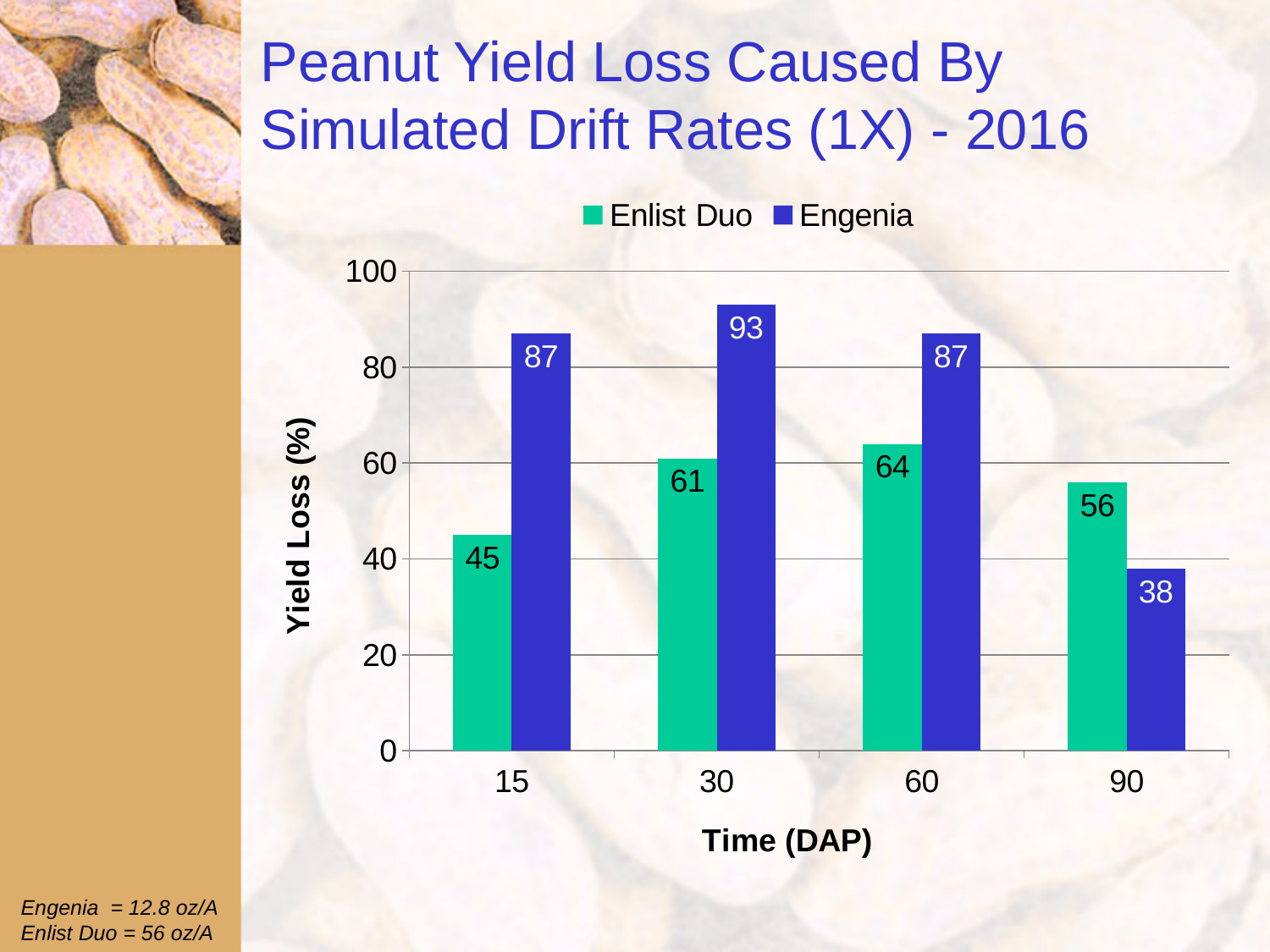
What is the yield loss for Enlist Duo at 15 DAP? 45 What is the yield loss for Engenia at 30 DAP? 93 Is the Enlist Duo yield loss at 60 DAP greater or less than 60? greater How many series does the legend list? 2 What is the difference between the Engenia and Enlist Duo yield loss at 15 DAP? 42 What is the label of the y axis? Yield Loss (%) What is the yield loss for Engenia at 90 DAP? 38 At which time (DAP) is the Engenia yield loss highest? 30 What kind of chart is shown on the slide? bar chart At which time (DAP) is the Enlist Duo yield loss lowest? 15 How many time points (DAP) are shown on the x axis? 4 At 90 DAP, which product has the larger yield loss, Enlist Duo or Engenia? Enlist Duo